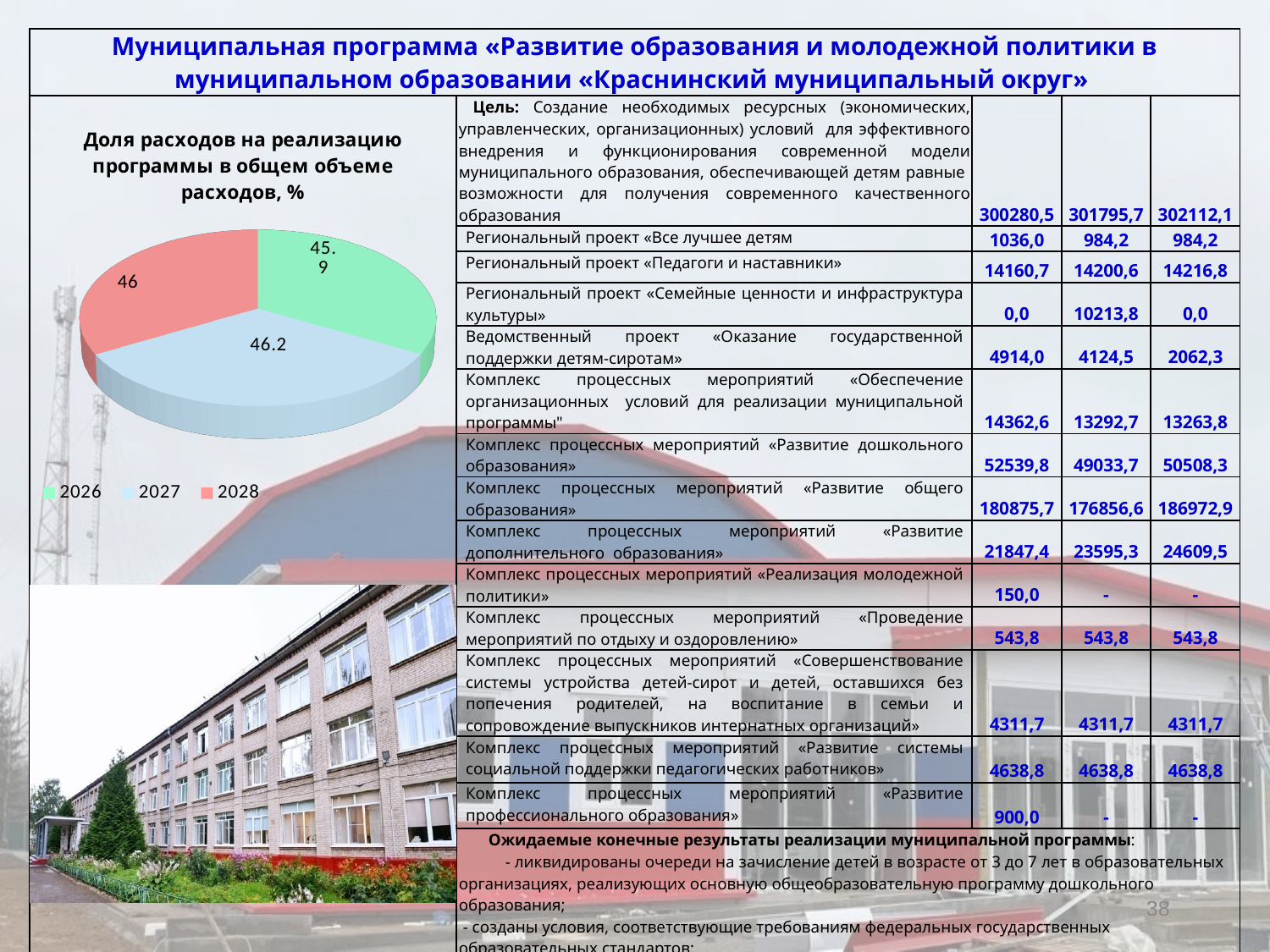
Which has the larger value in the pie chart, 2027 or 2028? 2027 What is the title of the pie chart? Доля расходов на реализацию программы в общем объеме расходов, % What is the value shown for 2026 in the pie chart? 45.9 Which year has the lowest value in the pie chart? 2026 What is the value shown for 2027 in the pie chart? 46.2 What is the value shown for 2028 in the pie chart? 46 How many slices does the pie chart have? 3 Which year has the highest value in the pie chart? 2027 Which year is shown in green in the pie chart? 2026 How many entries does the legend of the pie chart list? 3 What is the difference between the values for 2027 and 2026 in the pie chart? 0.3 What kind of chart is shown on the slide? pie chart